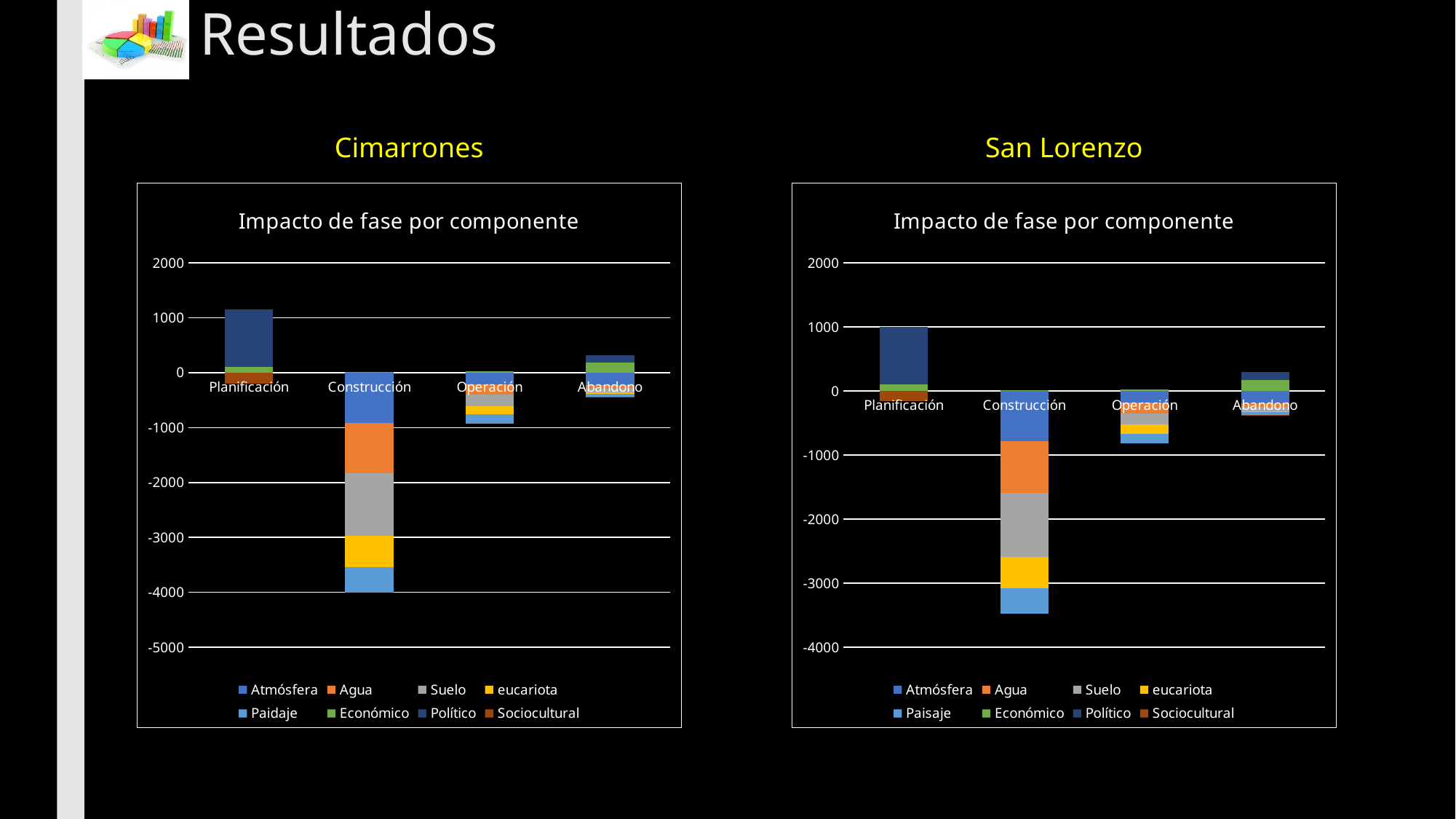
In the San Lorenzo chart, is the bottom of the Operación stacked bar greater or less than -1000? greater In the Cimarrones chart, which phase has the stacked bar extending furthest into negative values? Construcción What is the lowest value shown on the y axis of the Cimarrones chart? -5000 Which chart's Construcción bar reaches a lower (more negative) value, Cimarrones or San Lorenzo? Cimarrones How many series does the legend of the Cimarrones chart list? 8 What kind of chart is the Cimarrones chart? Stacked bar chart In the San Lorenzo chart, which phase has the tallest positive stacked bar? Planificación What is the title of the San Lorenzo chart? Impacto de fase por componente In the Cimarrones chart, is the bottom of the Construcción stacked bar greater or less than -3000? less How many phases (categories) are shown on the x axis of the San Lorenzo chart? 4 In the Cimarrones chart, is the top of the Planificación stacked bar greater or less than 1000? greater